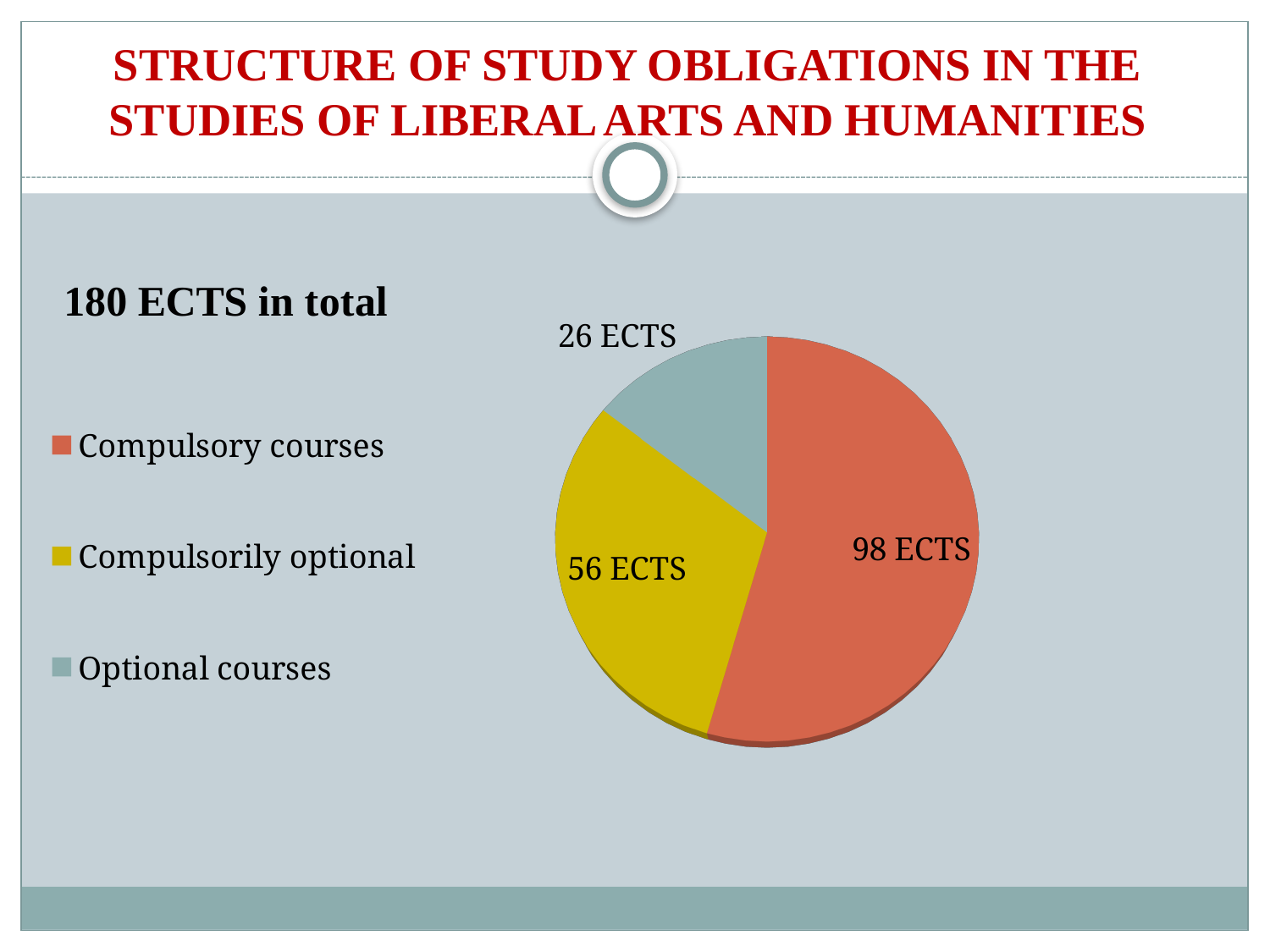
What is the difference in ECTS between Compulsorily optional and Optional courses? 30 ECTS What colour is the slice for Compulsorily optional? yellow Which is larger, Compulsorily optional or Optional courses? Compulsorily optional What is the difference in ECTS between Compulsory courses and Compulsorily optional? 42 ECTS Which category has the largest slice of the pie? Compulsory courses How many ECTS are shown for Optional courses? 26 ECTS What kind of chart is shown on the slide? pie chart How many ECTS are shown for Compulsory courses? 98 ECTS Which category has the smallest slice of the pie? Optional courses What is the total number of ECTS across all slices of the pie? 180 ECTS How many categories does the pie chart have? 3 How many ECTS are shown for Compulsorily optional? 56 ECTS